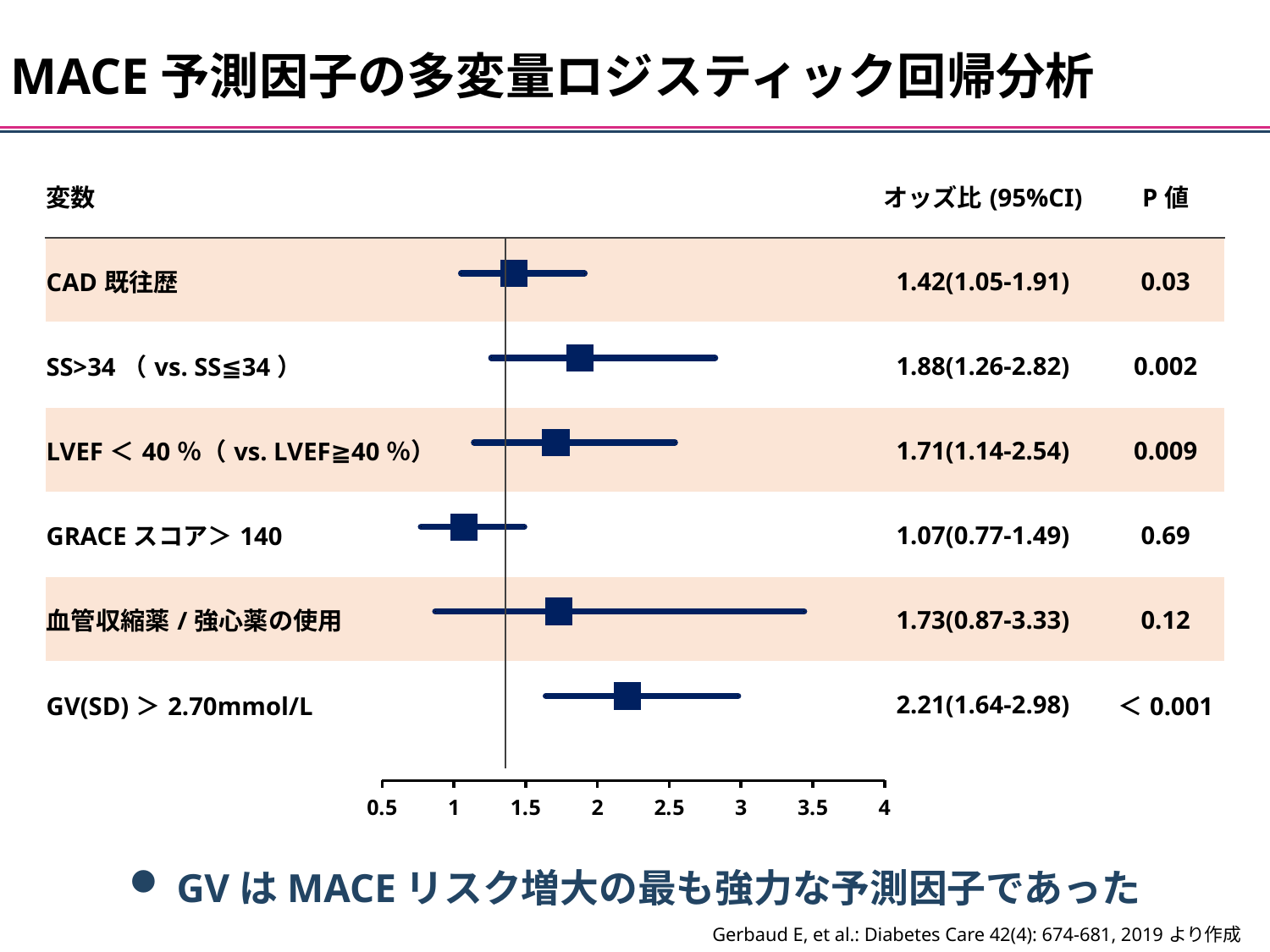
What is the odds ratio for CAD 既往歴? 1.42 Which variable has the highest odds ratio? GV(SD) > 2.70mmol/L What kind of chart is shown on the slide? Forest plot Which has the larger odds ratio, SS>34 (vs. SS≦34) or LVEF < 40 % (vs. LVEF≧40 %)? SS>34 (vs. SS≦34) What is the odds ratio for 血管収縮薬 / 強心薬の使用? 1.73 What is the title of the slide? MACE 予測因子の多変量ロジスティック回帰分析 Is the odds ratio for GV(SD) > 2.70mmol/L greater or less than 2? greater What is the difference between the odds ratio for GV(SD) > 2.70mmol/L and the odds ratio for GRACE スコア> 140? 1.14 What is the P value for SS>34 (vs. SS≦34)? 0.002 Which variable has the lowest odds ratio? GRACE スコア> 140 What is the 95% CI for GV(SD) > 2.70mmol/L? 1.64-2.98 How many variables are plotted in the chart? 6